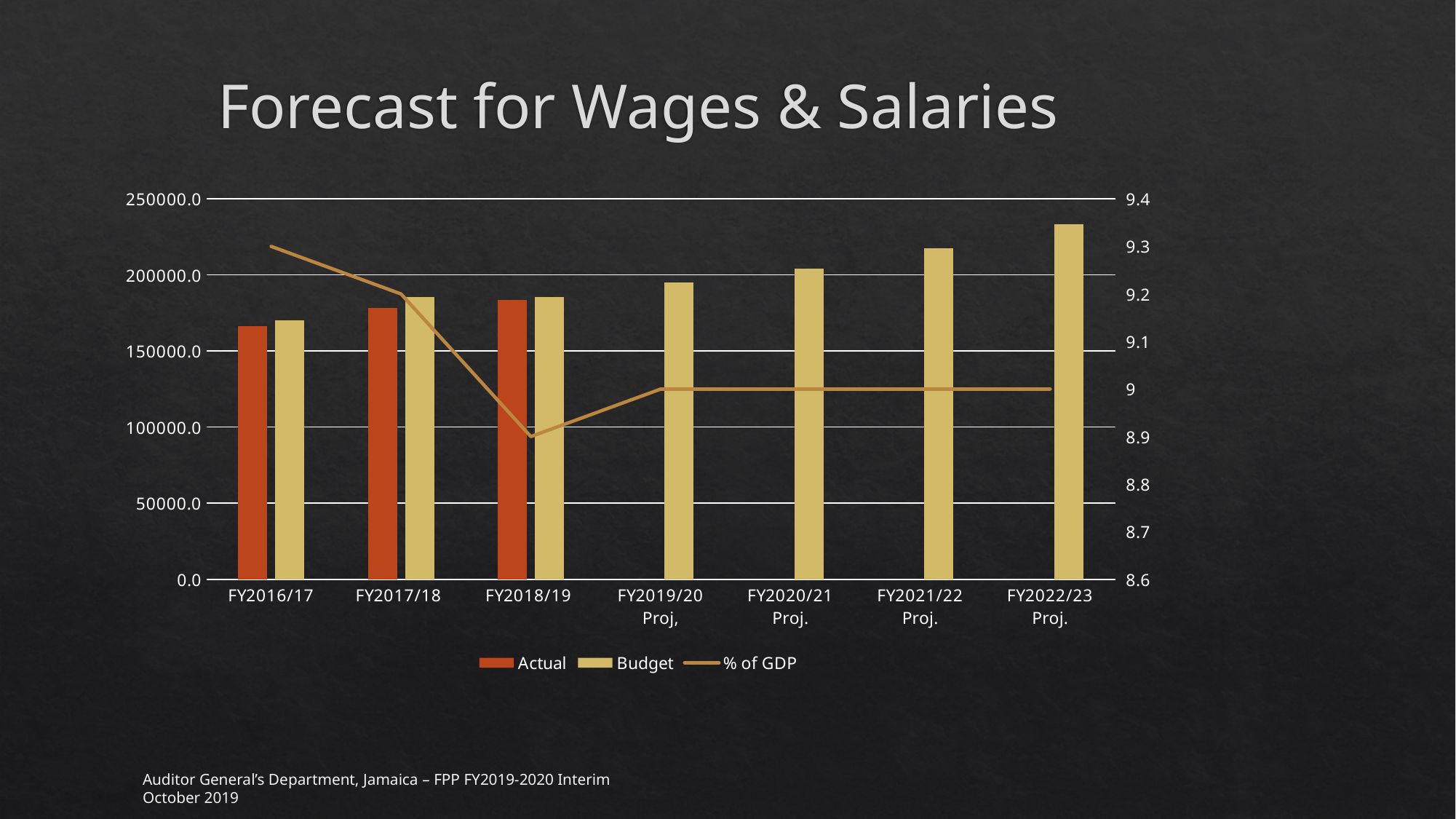
What kind of chart is used to show the Actual and Budget series? Bar chart Which fiscal year has the lowest Actual bar? FY2016/17 What is the title of the chart? Forecast for Wages & Salaries Does the Budget series rise or fall from FY2016/17 to FY2022/23 Proj.? Rise Is the Budget value for FY2022/23 Proj. greater or less than 200000.0? greater Is the % of GDP value for FY2018/19 greater or less than 9? less In FY2017/18, which is larger, the Actual bar or the Budget bar? Budget How many fiscal-year categories are shown on the x axis? 7 Which fiscal year has the highest Budget bar? FY2022/23 Proj. Which fiscal year has the lowest Budget bar? FY2016/17 Is the Actual value for FY2016/17 greater or less than 200000.0? less How many series does the legend list? 3